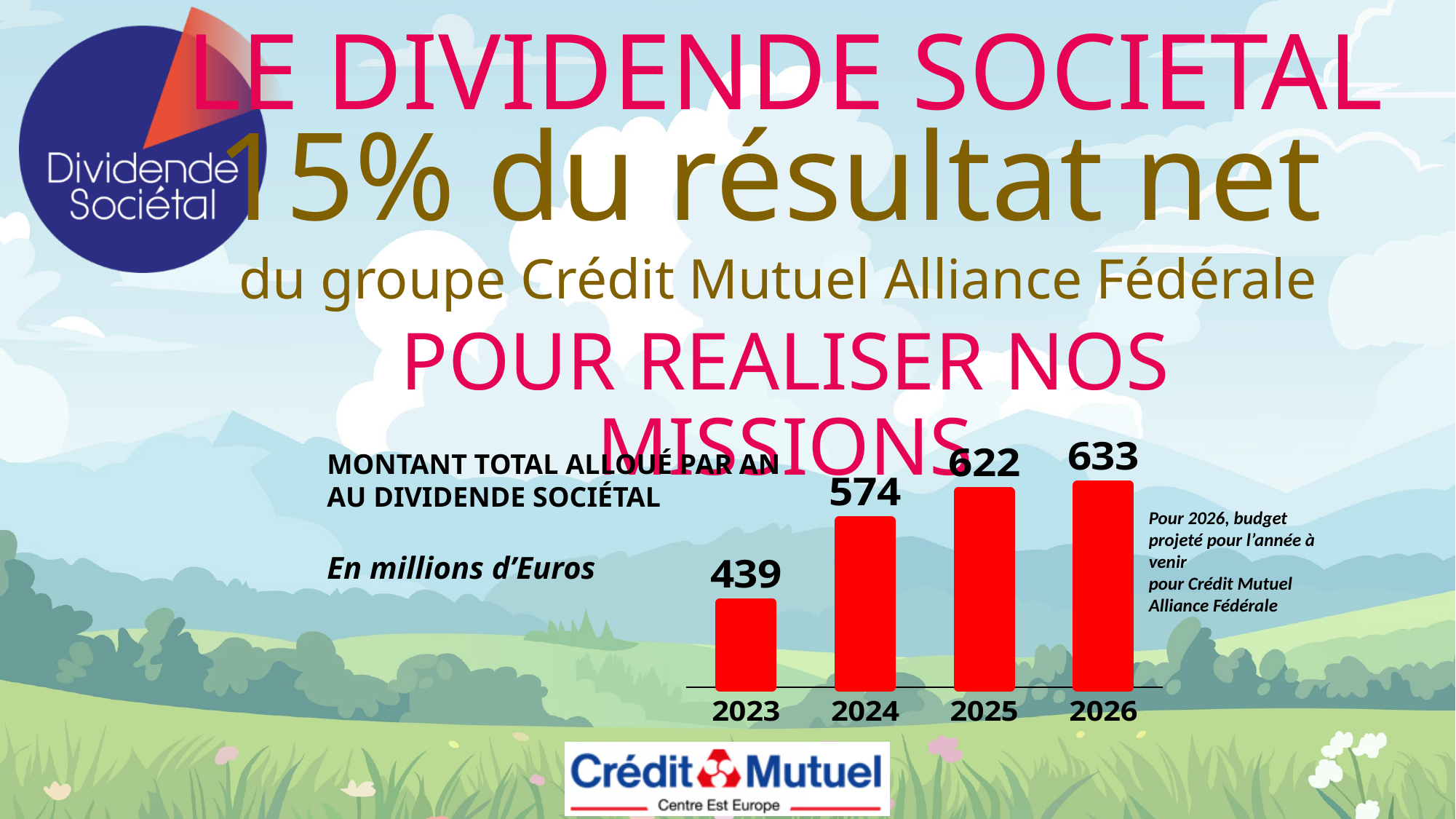
Do the values rise or fall from 2023 to 2026? Rise Which year has the highest value? 2026 Which is larger, the value for 2024 or the value for 2025? 2025 What is the difference between the values for 2024 and 2023? 135 What is the difference between the values for 2026 and 2025? 11 How many years are shown on the chart? 4 Which year has the lowest value? 2023 What is the value for 2026? 633 What is the value for 2024? 574 What is the value for 2023? 439 What is the value for 2025? 622 What kind of chart is shown? Bar chart